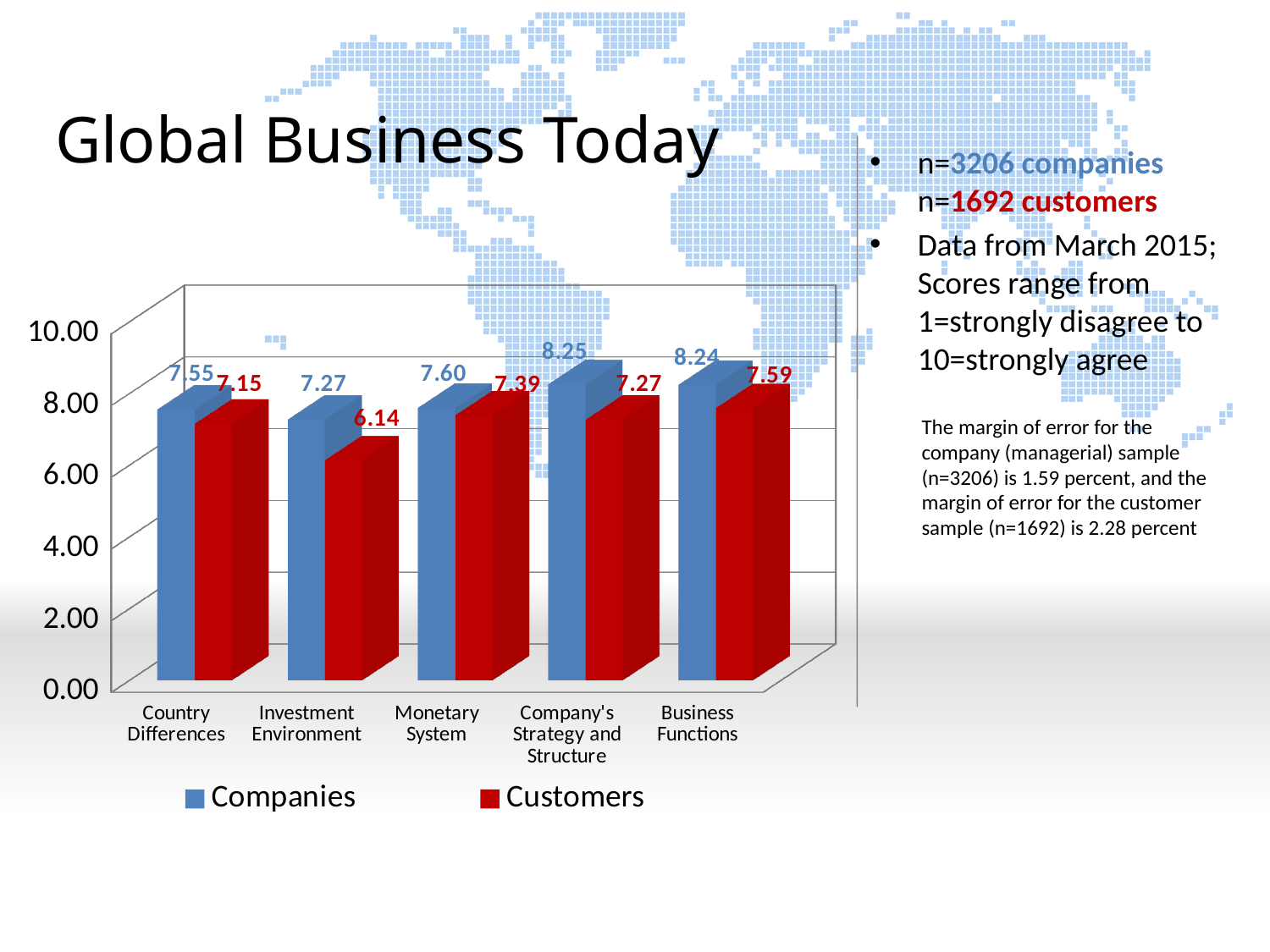
What is the difference between the Companies and Customers values for Investment Environment? 1.13 What is the Customers value for Investment Environment? 6.14 What is the Customers value for Business Functions? 7.59 How many categories are shown on the x axis? 5 What is the Companies value for Country Differences? 7.55 What kind of chart is shown on the slide? bar chart What is the difference between the Companies and Customers values for Company's Strategy and Structure? 0.98 Which category has the lowest Customers value? Investment Environment For Monetary System, which series has the larger value, Companies or Customers? Companies How many series does the legend list? 2 Is the Companies value for Business Functions greater or less than 8.00? greater Which category has the lowest Companies value? Investment Environment